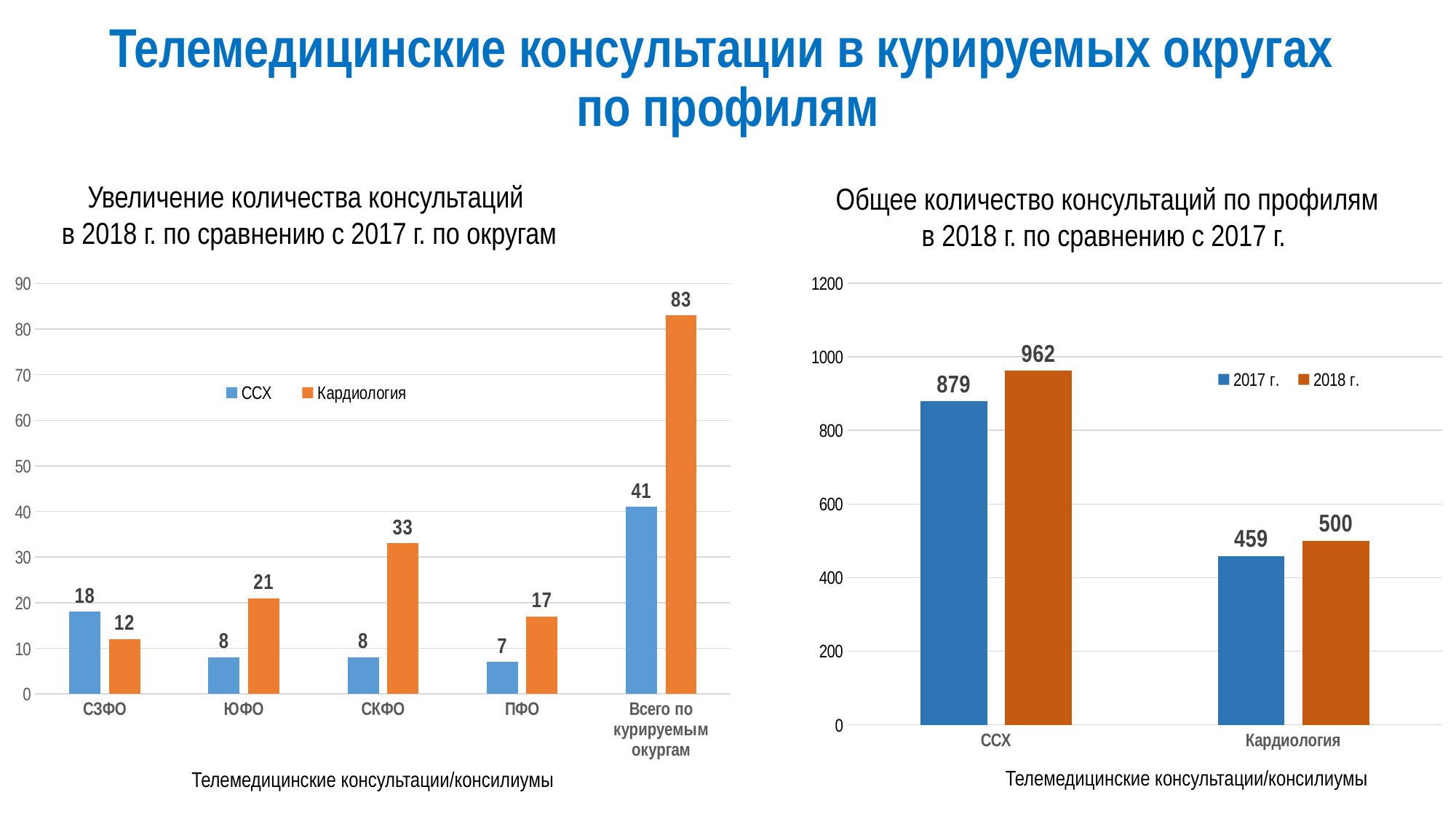
In the left chart (Увеличение количества консультаций), which category has the lowest ССХ value? ПФО In the right chart (Общее количество консультаций по профилям), what is the value for Кардиология in 2017 г.? 459 In the left chart (Увеличение количества консультаций), which category has the highest Кардиология value? Всего по курируемым округам In the left chart (Увеличение количества консультаций), what is the value for ССХ in СЗФО? 18 In the left chart (Увеличение количества консультаций), what is the difference between the Кардиология and ССХ values for Всего по курируемым округам? 42 In the left chart (Увеличение количества консультаций), how many categories are shown on the x axis? 5 In the right chart (Общее количество консультаций по профилям), how many series does the legend list? 2 In the left chart (Увеличение количества консультаций), which is larger in СЗФО: ССХ or Кардиология? ССХ In the right chart (Общее количество консультаций по профилям), what is the difference between the 2018 г. and 2017 г. values for ССХ? 83 In the left chart (Увеличение количества консультаций), what is the value for Кардиология in СКФО? 33 In the right chart (Общее количество консультаций по профилям), what is the value for ССХ in 2018 г.? 962 What type of chart is the right chart (Общее количество консультаций по профилям)? Bar chart